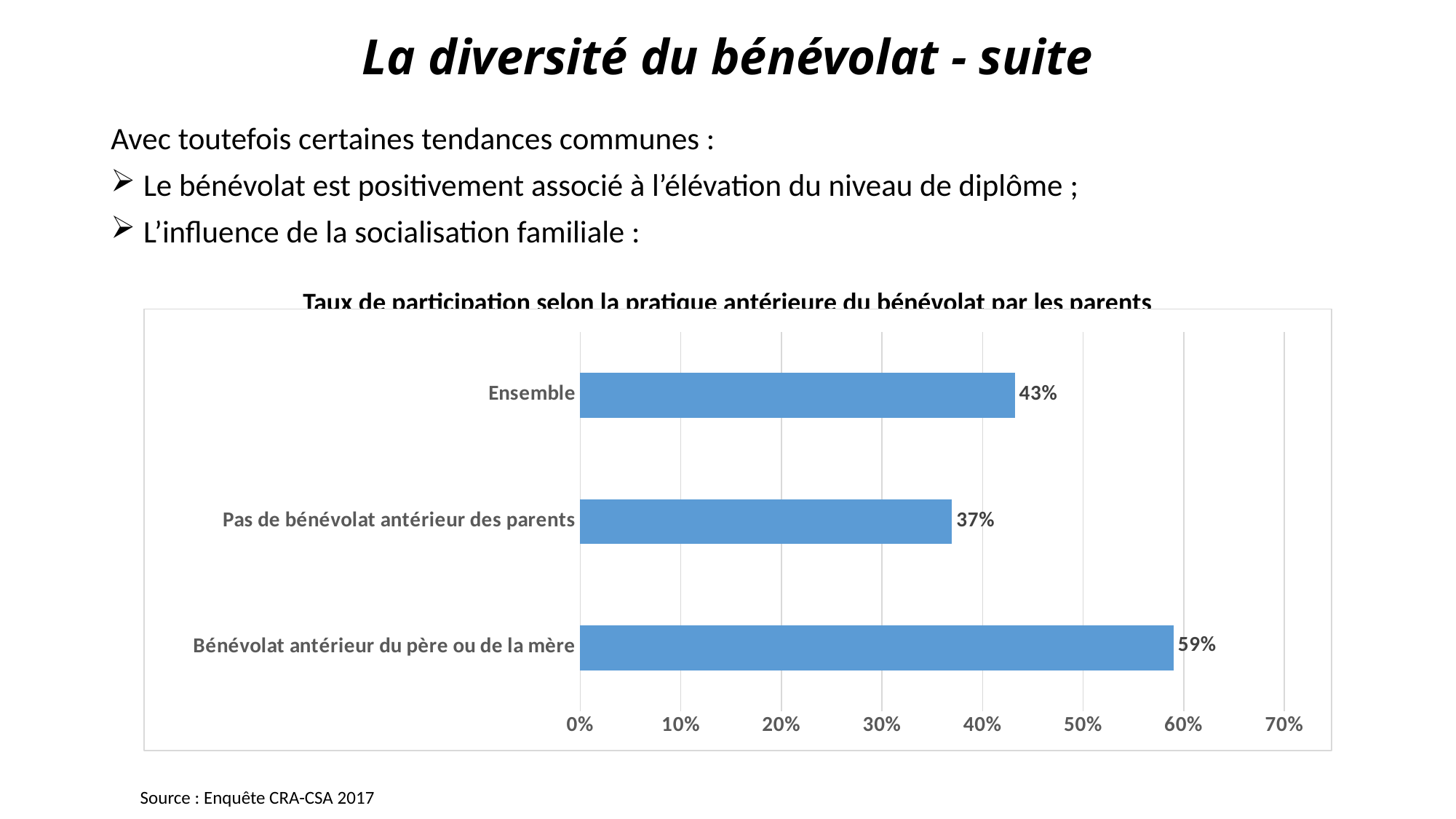
What is the title of the chart? Taux de participation selon la pratique antérieure du bénévolat par les parents What is the value for "Pas de bénévolat antérieur des parents"? 37% Which category has the lowest value? Pas de bénévolat antérieur des parents How many categories are shown in the chart? 3 Which is larger: the value for "Ensemble" or the value for "Pas de bénévolat antérieur des parents"? Ensemble What is the value for "Ensemble"? 43% What is the difference between the values for "Ensemble" and "Pas de bénévolat antérieur des parents"? 6% Is the value for "Bénévolat antérieur du père ou de la mère" greater or less than 50%? greater What is the value for "Bénévolat antérieur du père ou de la mère"? 59% What kind of chart is shown on the slide? Bar chart Which category has the highest value? Bénévolat antérieur du père ou de la mère What is the difference between the values for "Bénévolat antérieur du père ou de la mère" and "Pas de bénévolat antérieur des parents"? 22%